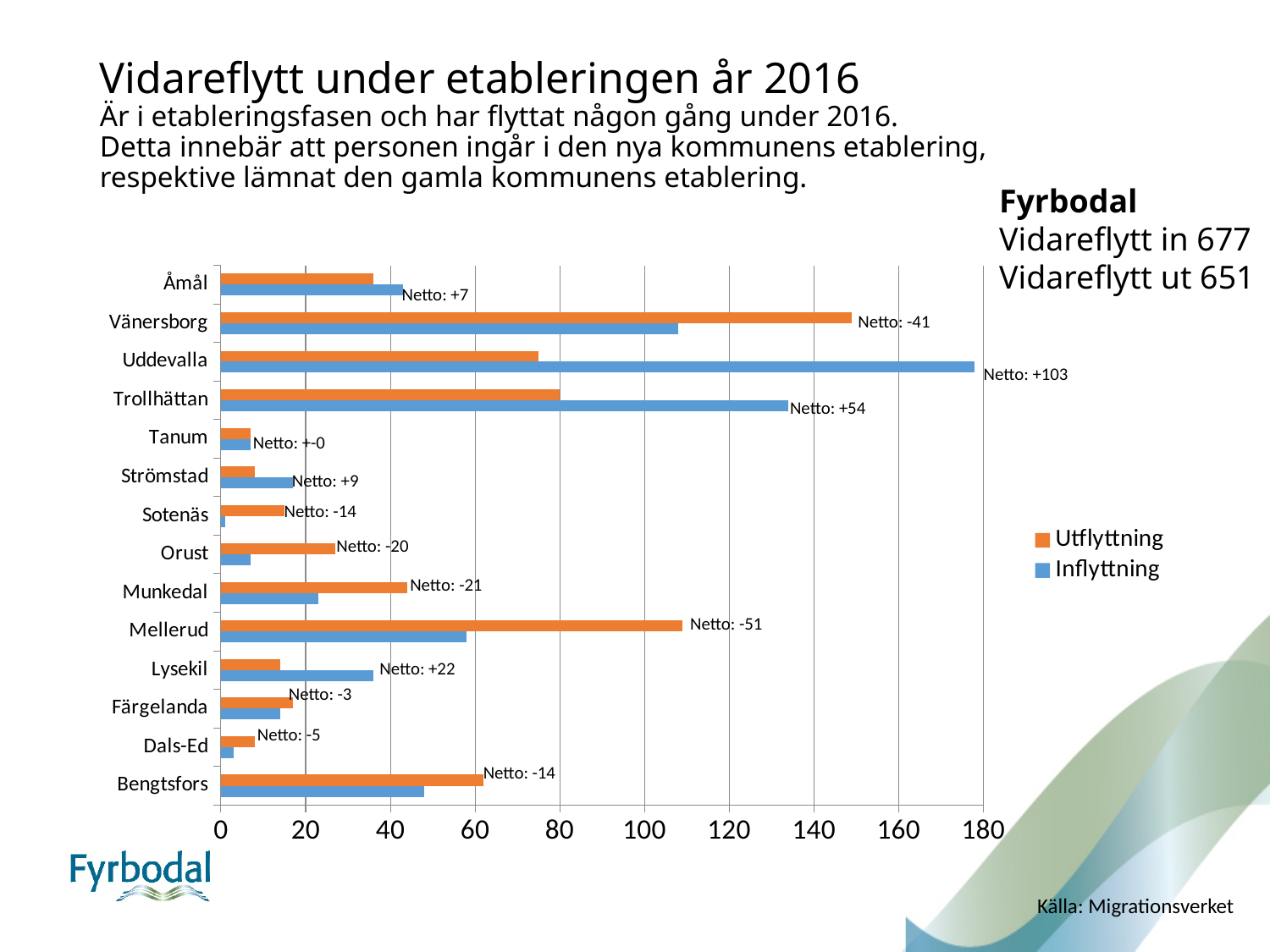
Which colour represents the Inflyttning series in the legend? Blue Is the Inflyttning value for Uddevalla greater or less than 160? greater What kind of chart is shown on the slide? Bar chart Is the Utflyttning value for Trollhättan greater or less than 100? less Which municipality has the highest Utflyttning value? Vänersborg For Mellerud, which is larger: Utflyttning or Inflyttning? Utflyttning What is the Netto value printed for Mellerud? Netto: -51 Which municipality has the highest Inflyttning value? Uddevalla How many municipalities are shown on the y axis of the chart? 14 What is the Netto value printed for Lysekil? Netto: +22 How many series does the legend list? 2 What is the Netto value printed for Uddevalla? Netto: +103